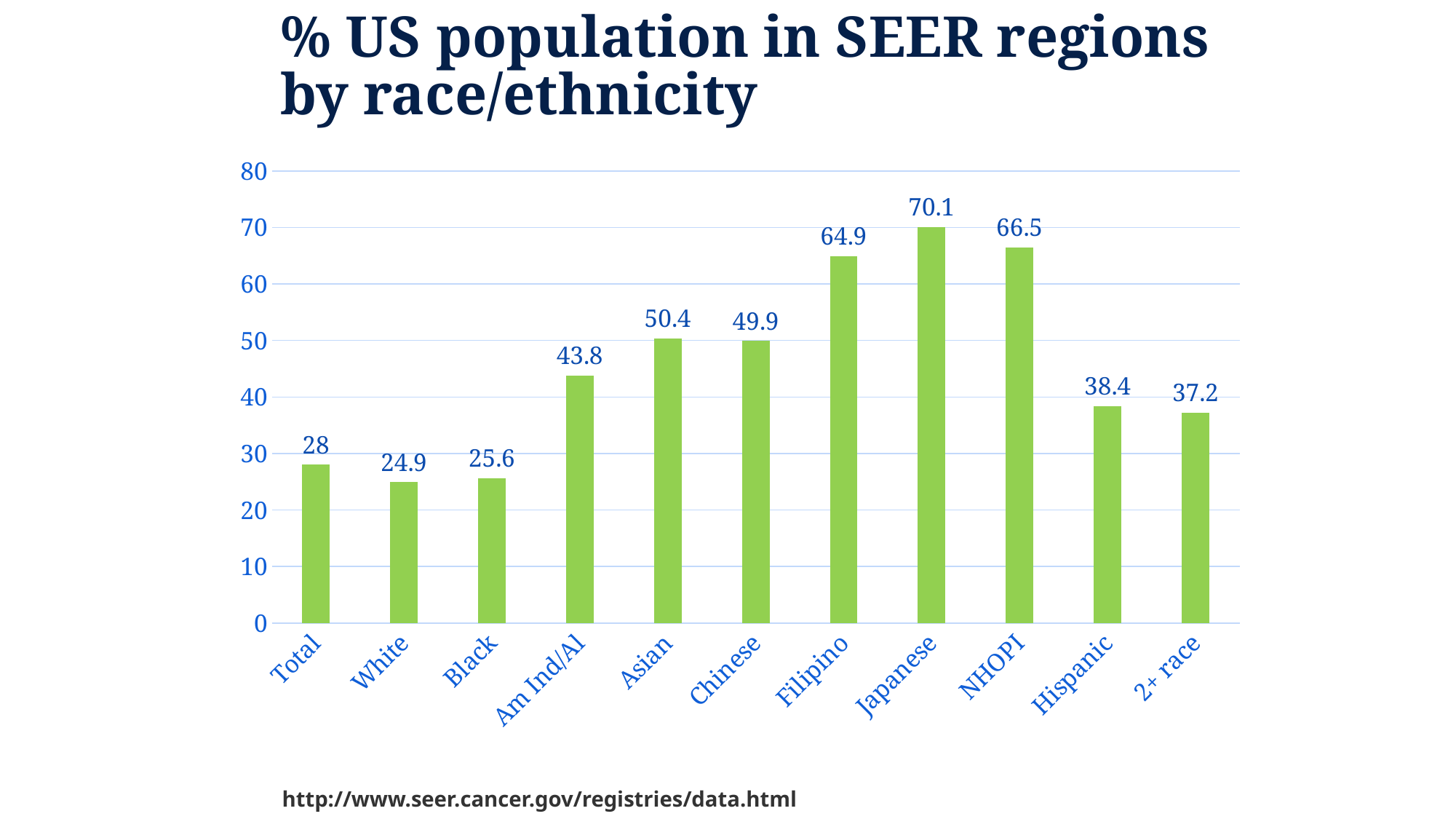
What is the title of the chart? % US population in SEER regions by race/ethnicity What is the difference between the values for Asian and Total? 22.4 What is the value for Hispanic? 38.4 What is the difference between the values for NHOPI and Filipino? 1.6 How many categories are shown on the x axis? 11 Which category has the highest value? Japanese What kind of chart is shown on the slide? bar chart Which is larger, the value for Hispanic or the value for 2+ race? Hispanic What is the value for Japanese? 70.1 Which category has the lowest value? White What is the value for Am Ind/AI? 43.8 Is the value for Chinese greater or less than 40? greater